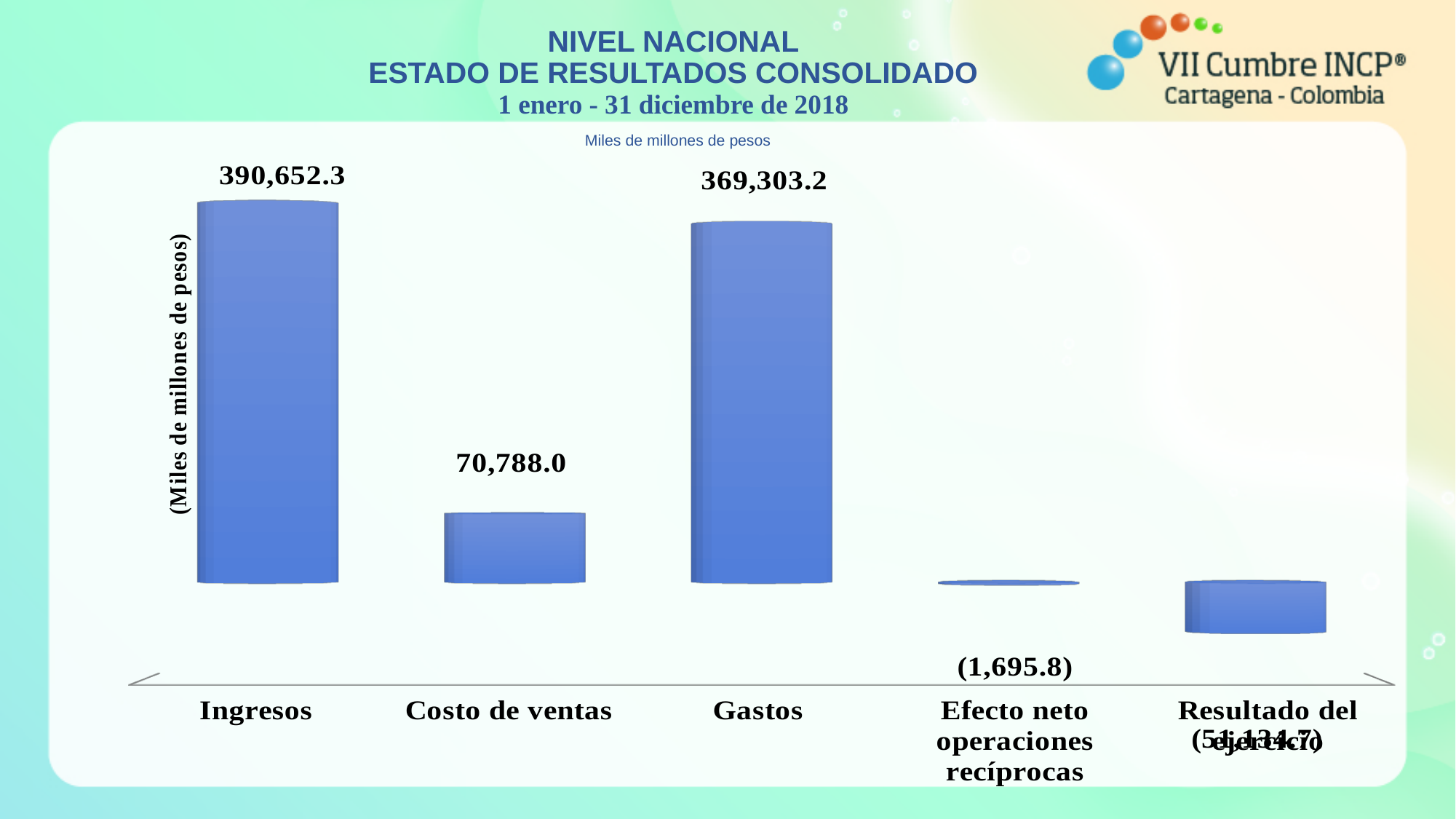
Which category has the lowest value? Resultado del ejercicio Which category has the highest value? Ingresos What is the value for Efecto neto operaciones recíprocas? (1,695.8) Which is larger, Ingresos or Gastos? Ingresos What is the value for Gastos? 369,303.2 What kind of chart is shown on the slide? Bar chart What is the difference between Ingresos and Costo de ventas? 319,864.3 What is the value for Ingresos? 390,652.3 How many categories are shown in the chart? 5 In what units are the values expressed, according to the chart? Miles de millones de pesos What is the difference between Ingresos and Gastos? 21,349.1 What is the value for Costo de ventas? 70,788.0